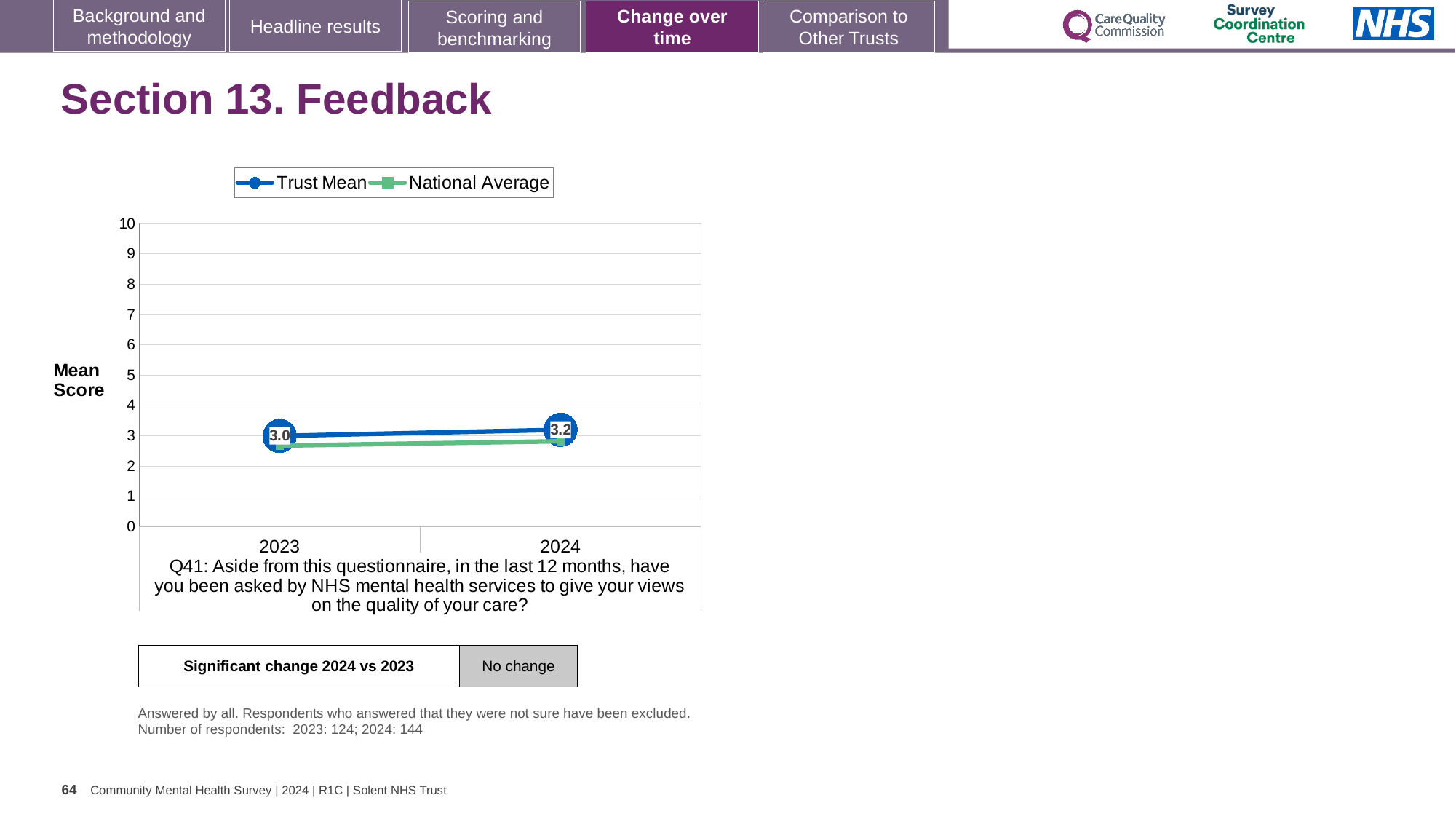
In which year is the Trust Mean lower? 2023 What is the Trust Mean value for 2023? 3.0 In 2024, which is larger: the Trust Mean or the National Average? Trust Mean What is the label on the y axis of the chart? Mean Score How many series does the legend list? 2 In which year is the Trust Mean higher? 2024 Is the National Average value for 2023 greater or less than 3? less By how much did the Trust Mean change from 2023 to 2024? 0.2 Does the Trust Mean rise or fall from 2023 to 2024? rise How many years are plotted on the x axis? 2 What is the Trust Mean value for 2024? 3.2 What kind of chart is shown on the slide? line chart